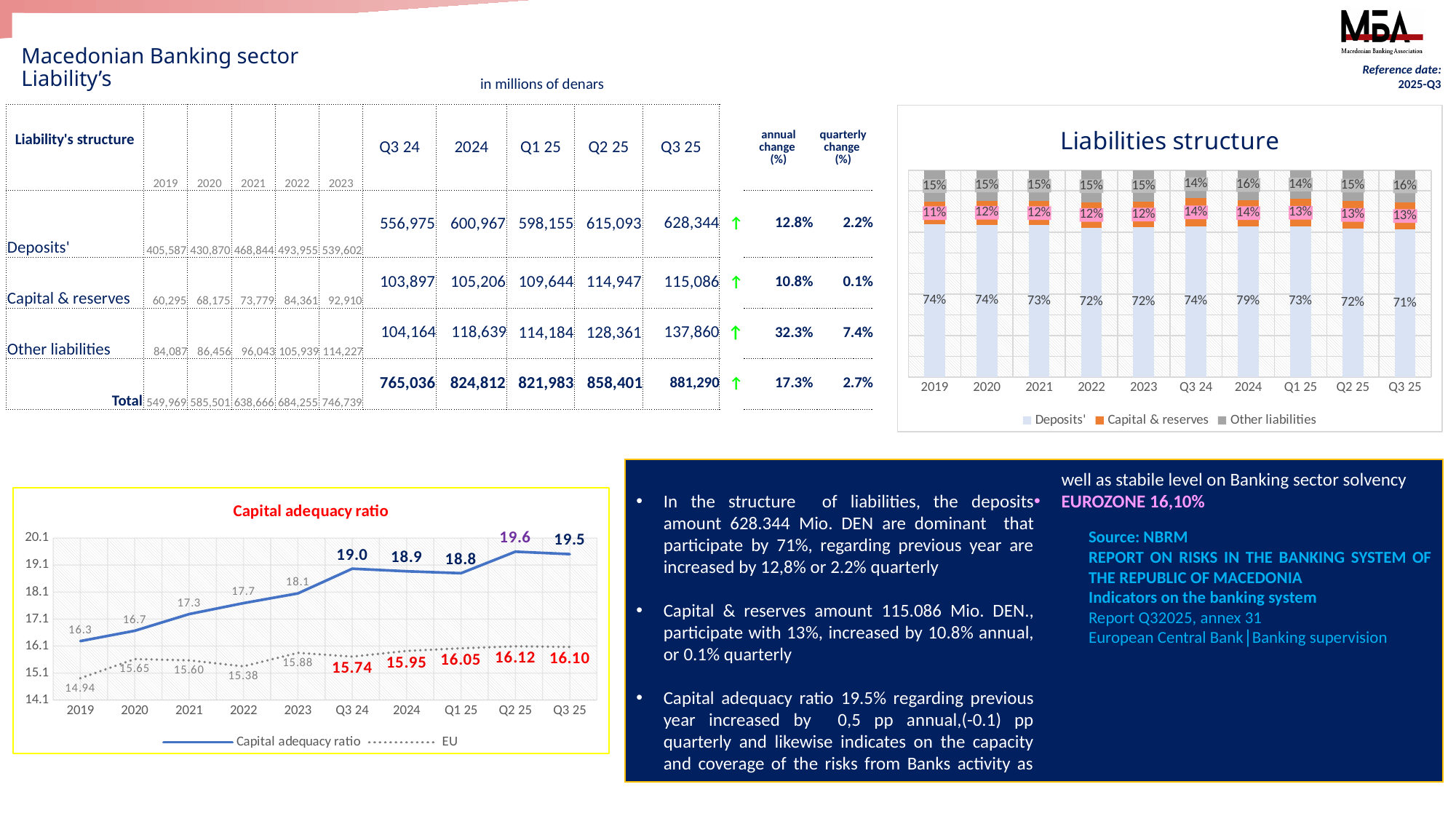
In the Capital adequacy ratio chart, what is the EU value for 2019? 14.94 In the Liabilities structure chart, what share do Other liabilities make up in Q3 25? 16% What kind of chart is the Liabilities structure chart? Stacked bar chart In the Capital adequacy ratio chart, what is the difference between the Capital adequacy ratio and the EU value in Q3 25? 3.4 In the Liabilities structure chart, what share do Capital & reserves make up in 2019? 11% In the Capital adequacy ratio chart, does the Capital adequacy ratio series rise or fall from 2019 to 2023? Rise In the Liabilities structure chart, how many series does the legend list? 3 In the Capital adequacy ratio chart, what is the Capital adequacy ratio value for Q3 25? 19.5 In the Capital adequacy ratio chart, which period has the highest Capital adequacy ratio value? Q2 25 In the Capital adequacy ratio chart, which is larger in Q3 24: the Capital adequacy ratio or the EU value? Capital adequacy ratio In the Liabilities structure chart, how many periods are shown on the x axis? 10 In the Liabilities structure chart, what share do Deposits' make up in Q3 25? 71%